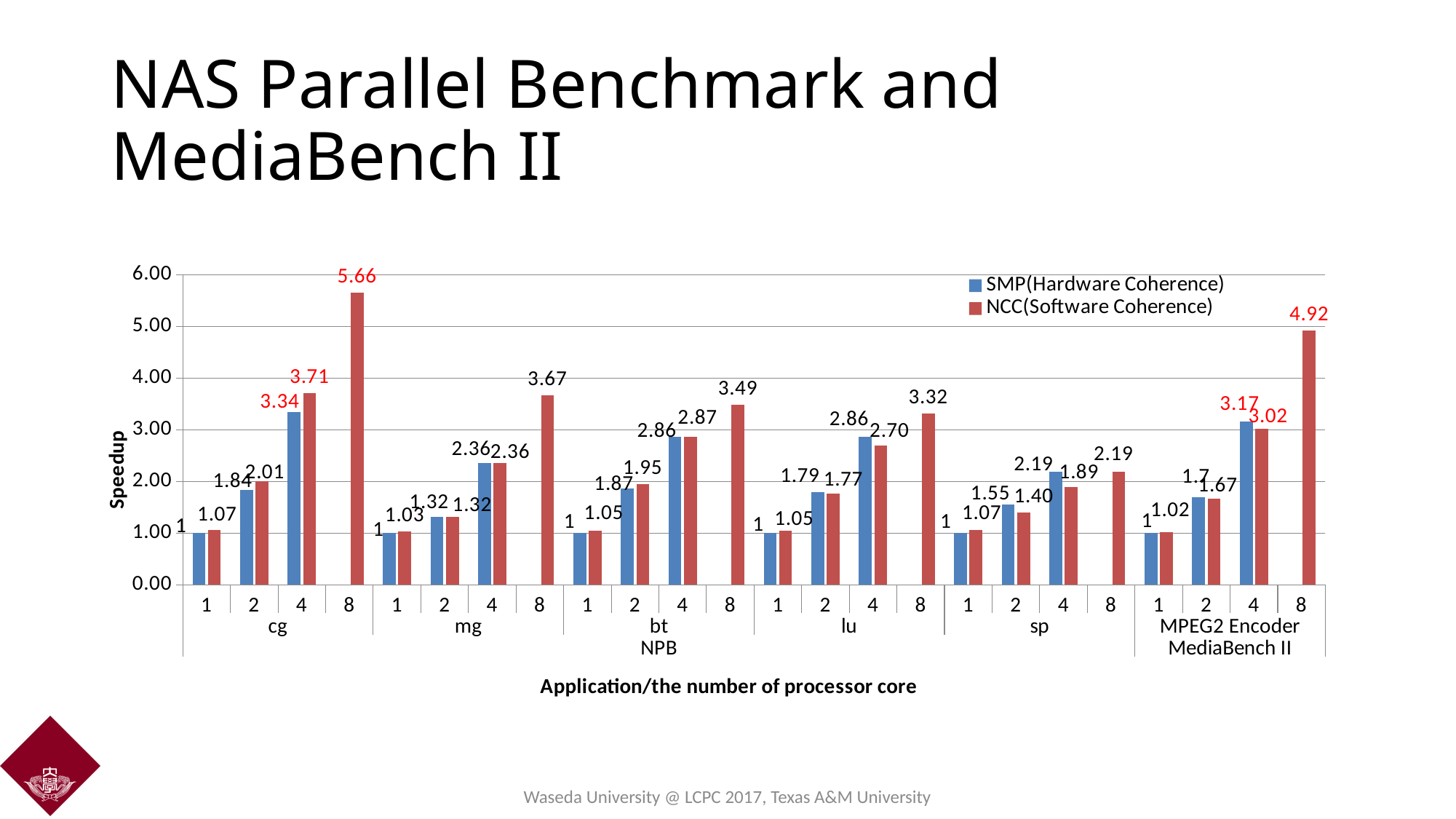
Which application and core count has the highest NCC(Software Coherence) speedup? cg with 8 cores What kind of chart is shown on the slide? Bar chart How many series does the legend list? 2 What is the NCC(Software Coherence) speedup for sp with 2 processor cores? 1.40 What is the NCC(Software Coherence) speedup for cg with 8 processor cores? 5.66 Is the NCC(Software Coherence) speedup for MPEG2 Encoder with 8 cores greater or less than 4.00? greater What is the SMP(Hardware Coherence) speedup for MPEG2 Encoder with 4 processor cores? 3.17 What is the label of the y axis? Speedup What is the difference between the NCC and SMP speedups for cg with 4 processor cores? 0.37 Which application has the lowest NCC(Software Coherence) speedup at 8 processor cores? sp How many applications are shown along the x axis? 6 For lu with 4 processor cores, which is larger: the SMP(Hardware Coherence) speedup or the NCC(Software Coherence) speedup? SMP(Hardware Coherence)